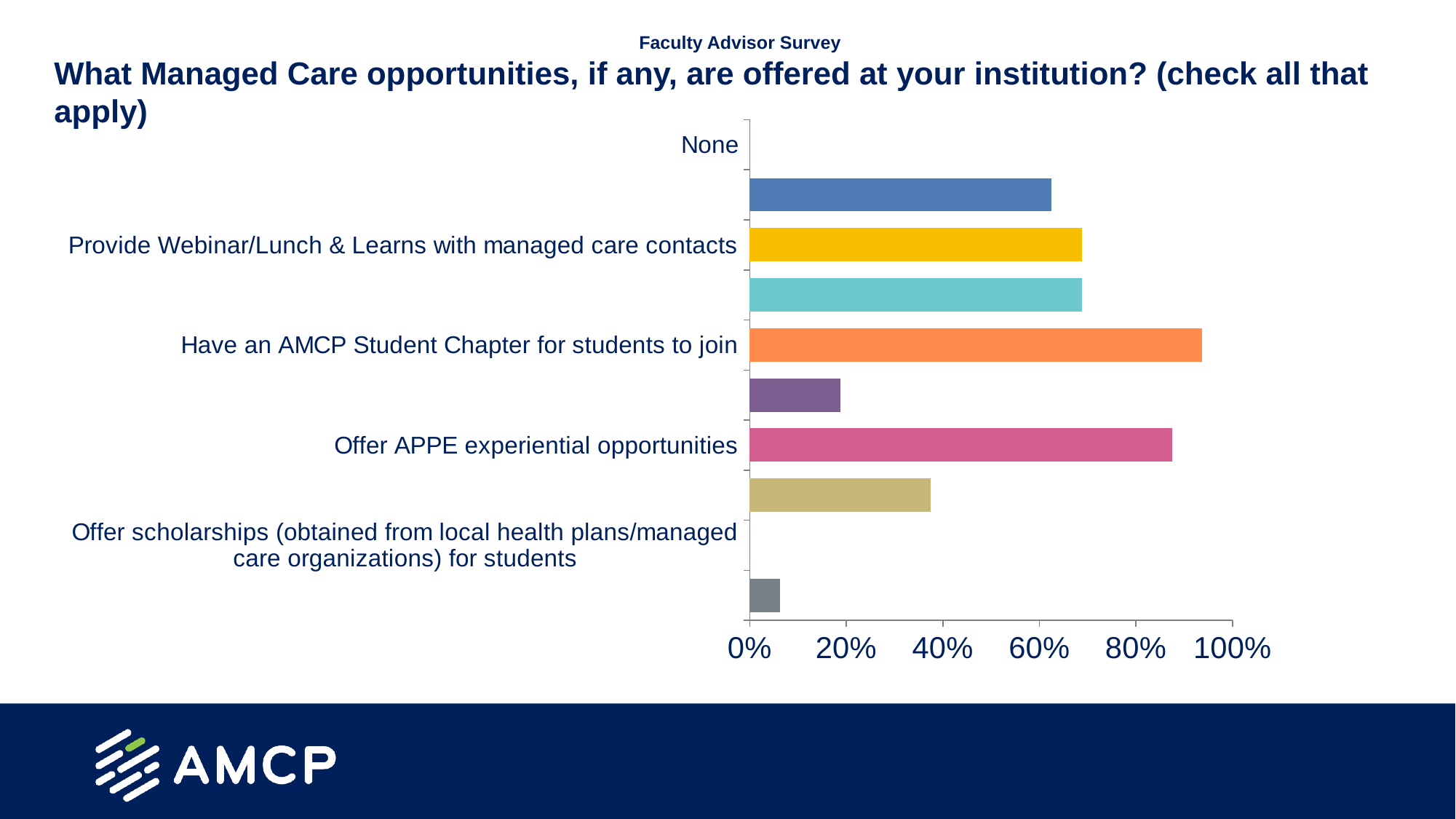
What is the highest value shown on the horizontal axis? 100% What kind of chart is shown on the slide? bar chart Is the value for "Have an AMCP Student Chapter for students to join" greater or less than 80%? greater Is the value for "Provide Webinar/Lunch & Learns with managed care contacts" greater or less than 60%? greater Is the value for "Provide Webinar/Lunch & Learns with managed care contacts" greater or less than 80%? less Which is larger: the value for "Offer APPE experiential opportunities" or the value for "Provide Webinar/Lunch & Learns with managed care contacts"? Offer APPE experiential opportunities What survey is the chart's data from, according to the text above the title? Faculty Advisor Survey Among the labeled categories, which has the highest value? Have an AMCP Student Chapter for students to join Which is larger: the value for "Have an AMCP Student Chapter for students to join" or the value for "Provide Webinar/Lunch & Learns with managed care contacts"? Have an AMCP Student Chapter for students to join